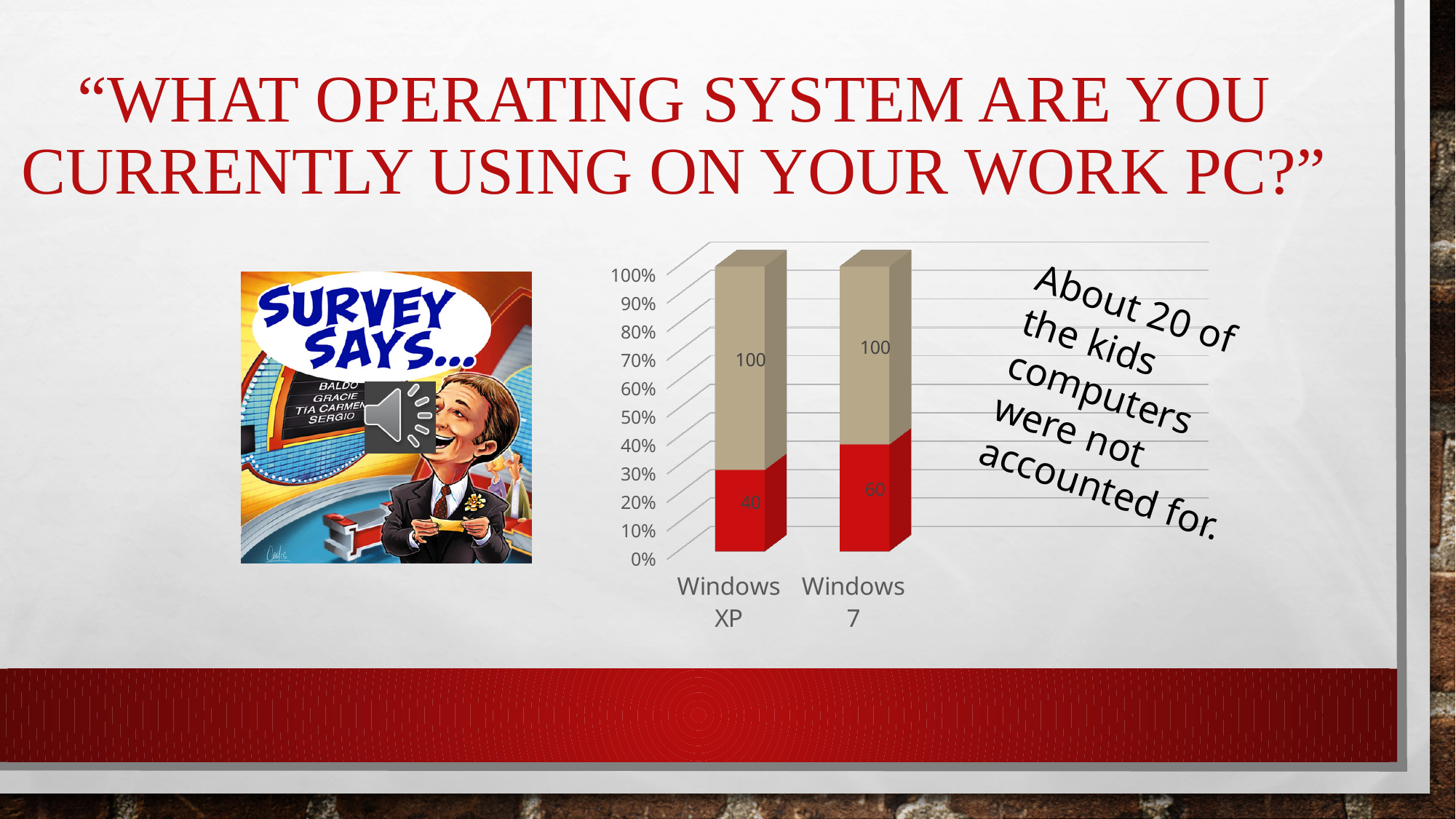
What kind of chart is shown on the slide? Stacked bar chart Which category has the larger red segment value, Windows XP or Windows 7? Windows 7 What is the value of the tan (upper) segment for Windows XP? 100 How many categories are shown on the x axis of the chart? 2 What is the highest tick label shown on the chart's vertical axis? 100% What is the value of the red segment for Windows 7? 60 What is the value of the tan (upper) segment for Windows 7? 100 Is the red segment for Windows 7 greater or less than 30% of its bar on the percentage axis? greater What is the total of the two labelled segments in the Windows 7 bar? 160 What is the value of the red segment for Windows XP? 40 What is the total of the two labelled segments in the Windows XP bar? 140 What is the difference between the red segment values for Windows 7 and Windows XP? 20